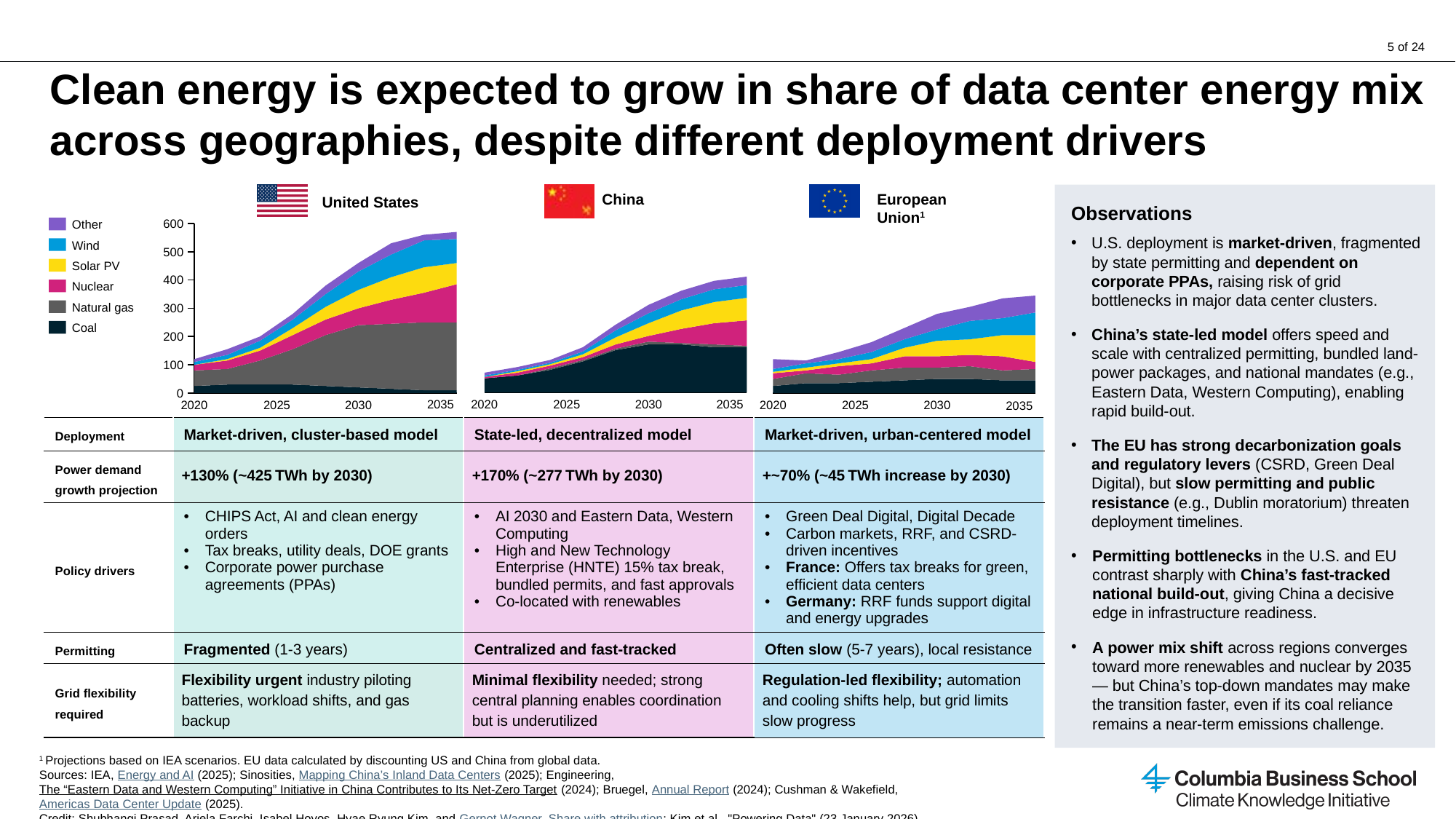
Which series in the legend is shown in yellow? Solar PV How many series does the shared legend list for the energy mix charts? 6 In the European Union chart, is the total value in 2035 greater or less than 400? less Comparing the 2035 totals, which is larger: the United States chart or the China chart? United States In the European Union chart, is the total value in 2020 greater or less than 200? less What kind of chart is used to show the data center energy mix for the United States, China and the European Union? Stacked area chart Which of the three charts shows the highest total energy mix in 2035? United States In the China chart, does the total energy mix rise or fall from 2020 to 2035? Rises In the United States chart, does the total energy mix rise or fall from 2020 to 2035? Rises In the United States chart, is the total value in 2035 greater or less than 500? greater How many energy mix charts are shown on the slide? 3